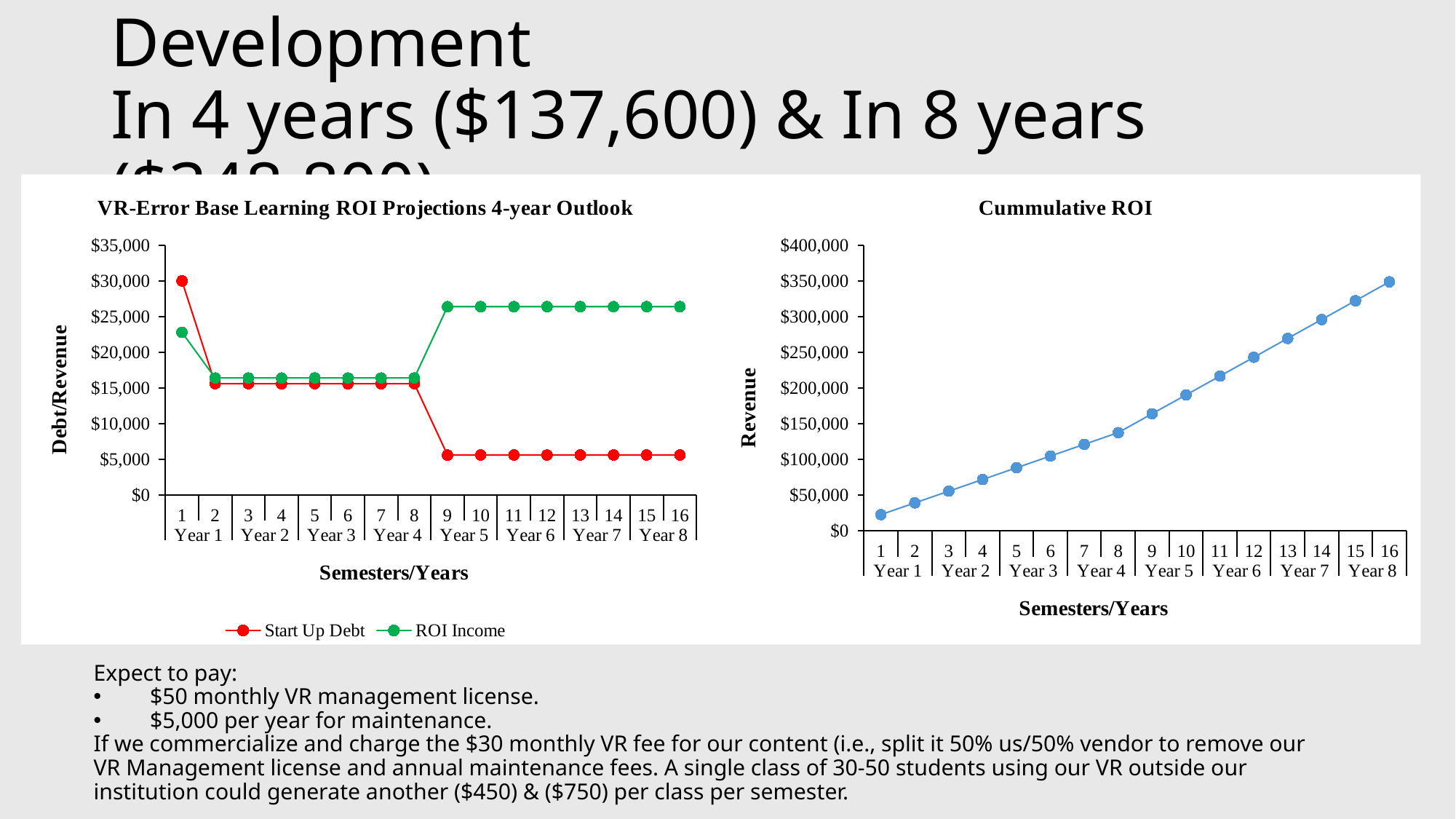
What is the y-axis title of the left chart ('VR-Error Base Learning ROI Projections 4-year Outlook')? Debt/Revenue In the left chart ('VR-Error Base Learning ROI Projections 4-year Outlook'), which series has the larger value at semester 12, Start Up Debt or ROI Income? ROI Income What kind of chart is the 'VR-Error Base Learning ROI Projections 4-year Outlook' chart on the left? Line chart How many series does the legend of the left chart ('VR-Error Base Learning ROI Projections 4-year Outlook') list? 2 In the 'Cummulative ROI' chart on the right, is the value at semester 16 greater or less than $300,000? greater What are the two series named in the legend of the left chart ('VR-Error Base Learning ROI Projections 4-year Outlook')? Start Up Debt and ROI Income What kind of chart is the 'Cummulative ROI' chart on the right? Line chart How many semesters are plotted along the x axis of the left chart ('VR-Error Base Learning ROI Projections 4-year Outlook')? 16 In the left chart ('VR-Error Base Learning ROI Projections 4-year Outlook'), is the Start Up Debt value at semester 1 greater or less than $25,000? greater In the 'Cummulative ROI' chart on the right, do the values rise or fall from semester 1 to semester 16? Rise In the left chart ('VR-Error Base Learning ROI Projections 4-year Outlook'), is the Start Up Debt value at semester 9 greater or less than $10,000? less In the 'Cummulative ROI' chart on the right, which semester has the highest value? Semester 16 (Year 8)